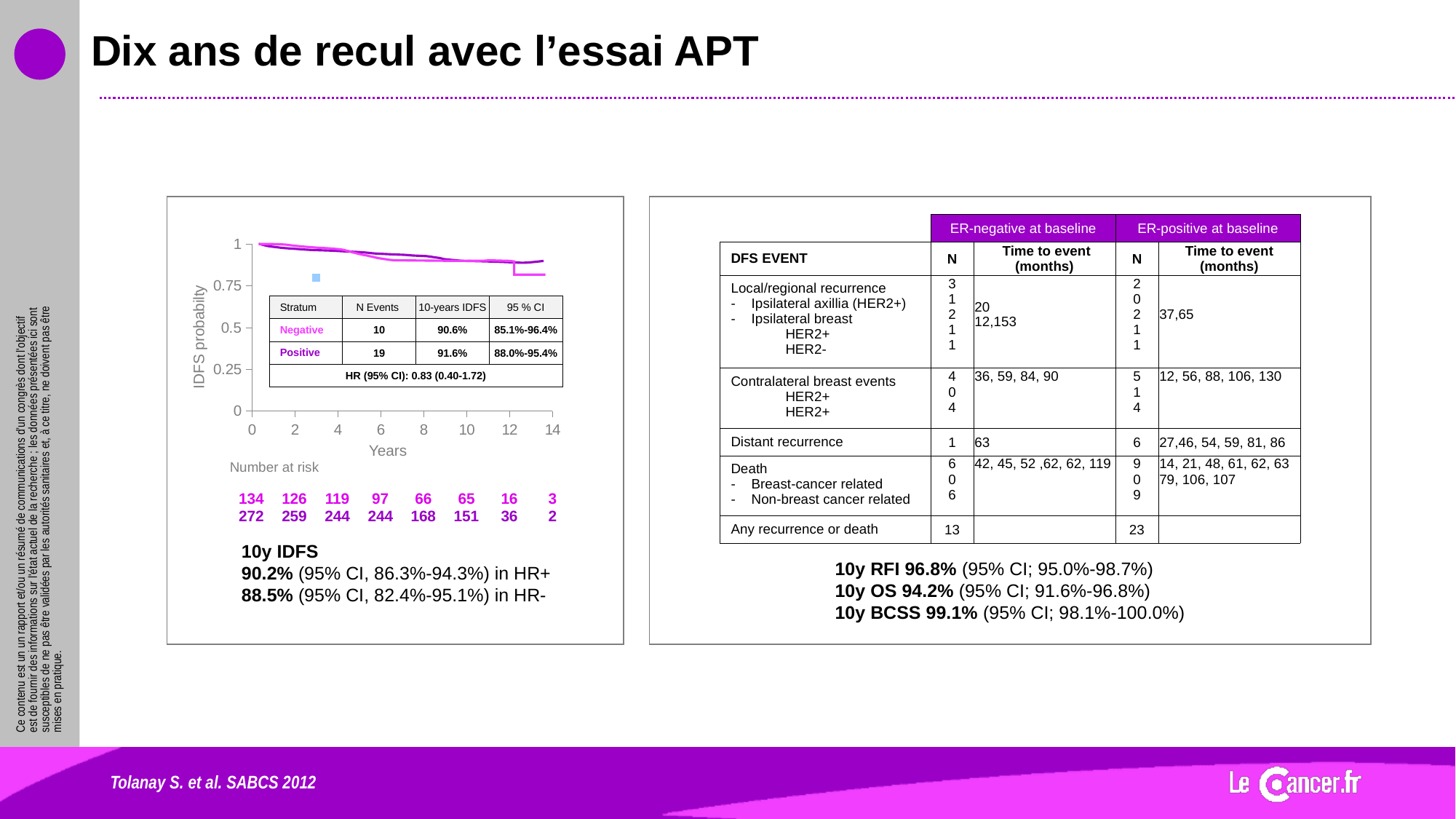
What kind of chart is shown on the left of the slide? line chart In the IDFS chart's inset table, what is the difference in N Events between the Positive and Negative strata? 9 What is the label of the x axis of the IDFS probability chart? Years In the IDFS chart's inset table, which stratum has more events, Negative or Positive? Positive In the IDFS chart's inset table, what is the 10-years IDFS for the Positive stratum? 91.6% In the IDFS chart, what is the number at risk at year 0 in the top (magenta) row? 134 What is the 95% CI for the 10-years IDFS of the Negative stratum in the IDFS chart's inset table? 85.1%-96.4% In the IDFS chart's inset table, what is the 10-years IDFS for the Negative stratum? 90.6% In the IDFS chart, is the IDFS probability at year 10 greater or less than 0.75? greater In the IDFS chart's inset table, how many events (N Events) are reported for the Positive stratum? 19 How many strata are plotted in the IDFS probability chart? 2 In the IDFS chart's inset table, how many events (N Events) are reported for the Negative stratum? 10